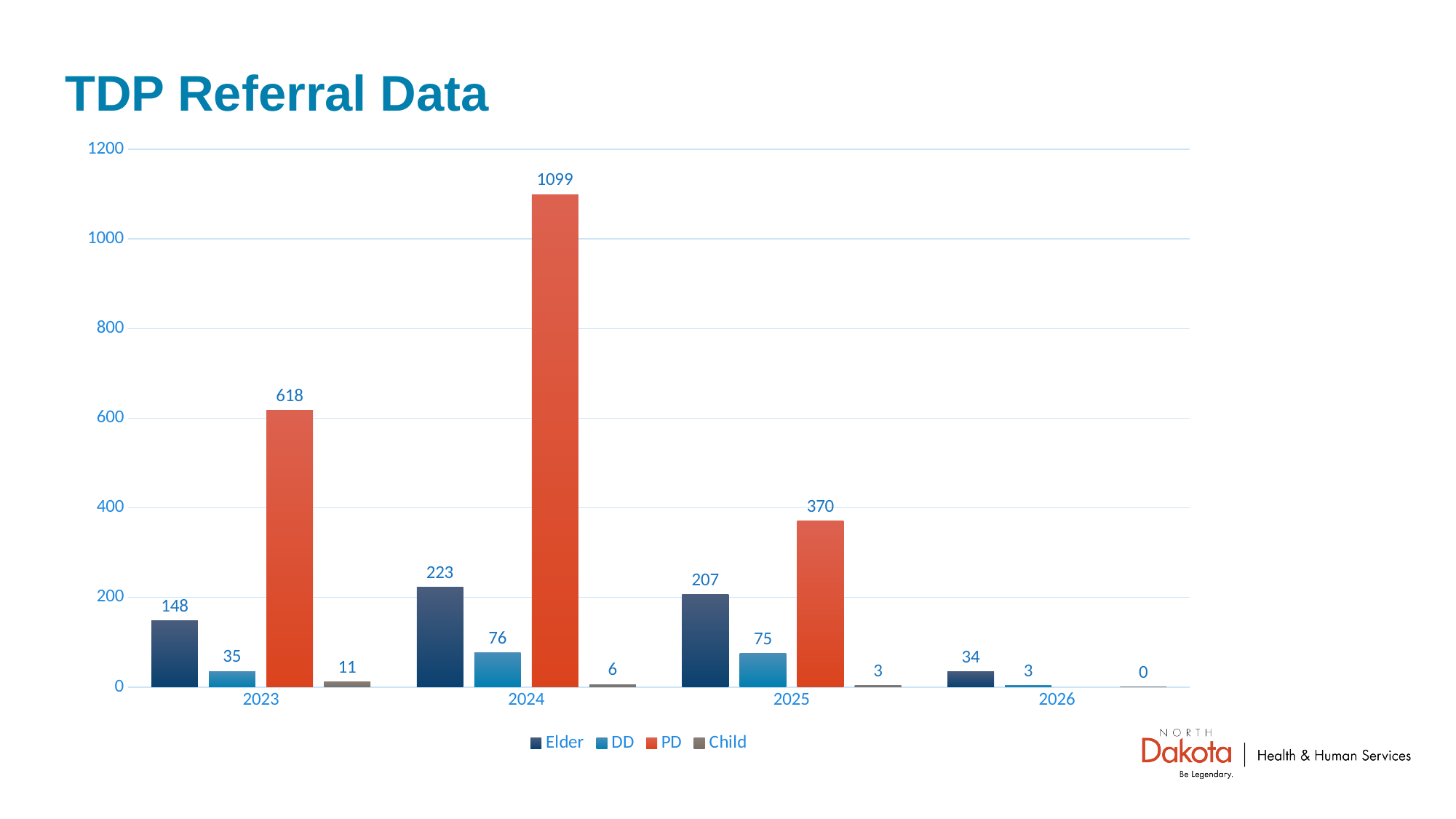
What is the value for PD in 2024? 1099 What is the value for Elder in 2023? 148 Which year has the larger Elder value, 2024 or 2025? 2024 How many years are shown on the x axis? 4 Is the value for PD in 2025 greater or less than 400? less What kind of chart is shown on the slide? bar chart How many series does the legend list? 4 What is the value for DD in 2025? 75 What is the difference between the PD value in 2024 and the PD value in 2023? 481 In which year is the PD value highest? 2024 What is the value for Child in 2023? 11 In which year is the Elder value lowest? 2026